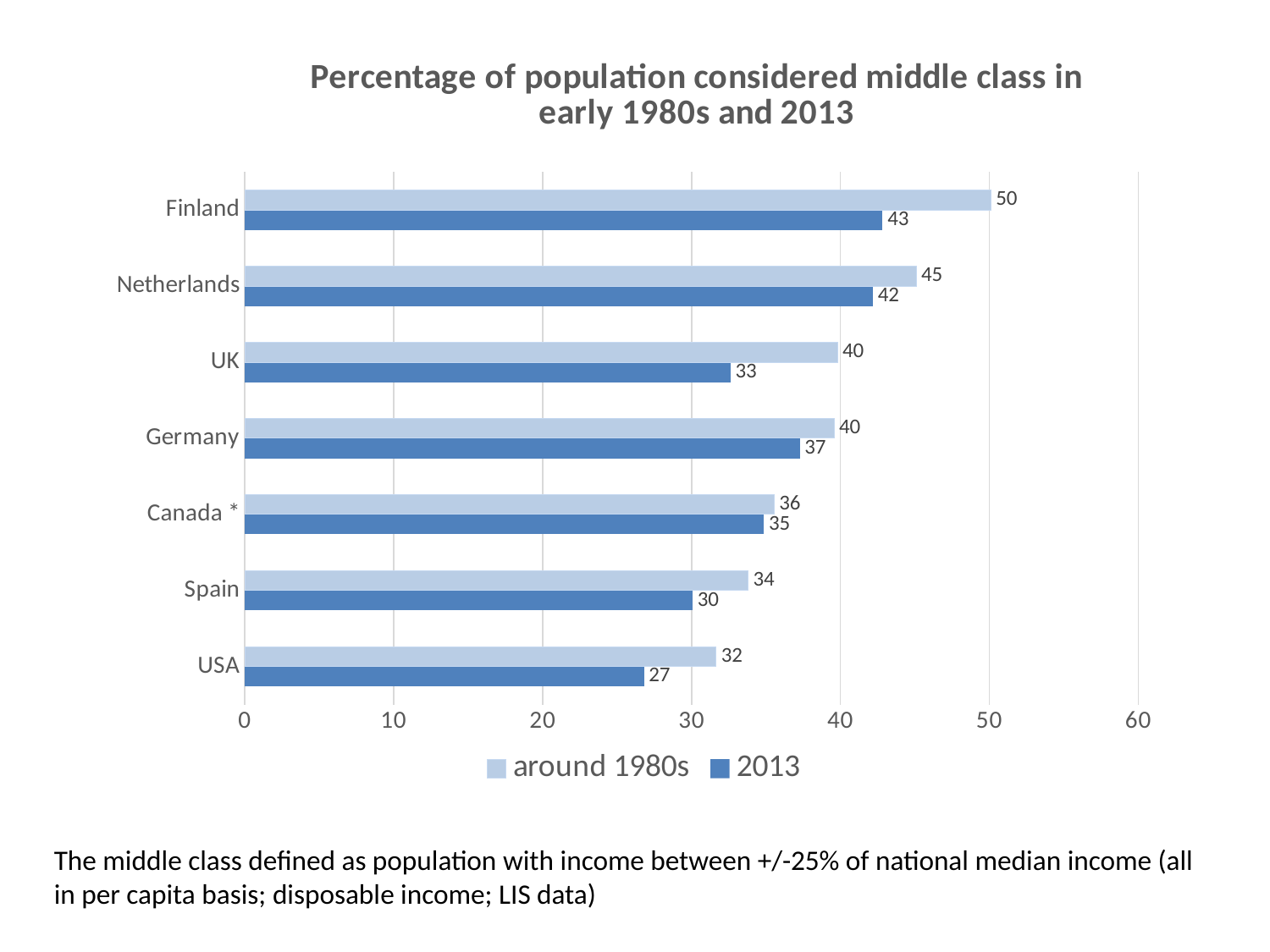
Which country has the lowest value in the 'around 1980s' series? USA How many countries are shown on the chart? 7 What is the value for Finland in the 'around 1980s' series? 50 What is the difference between the 'around 1980s' and 2013 values for the UK? 7 Which is larger: the 2013 value for Germany or the 2013 value for the Netherlands? Netherlands What kind of chart is shown on the slide? Bar chart What is the difference between the 'around 1980s' values for Finland and the USA? 18 What is the value for the USA in the 2013 series? 27 Which country has the highest value in the 2013 series? Finland What are the two series listed in the legend? around 1980s and 2013 What is the value for the UK in the 2013 series? 33 How many series does the legend list? 2